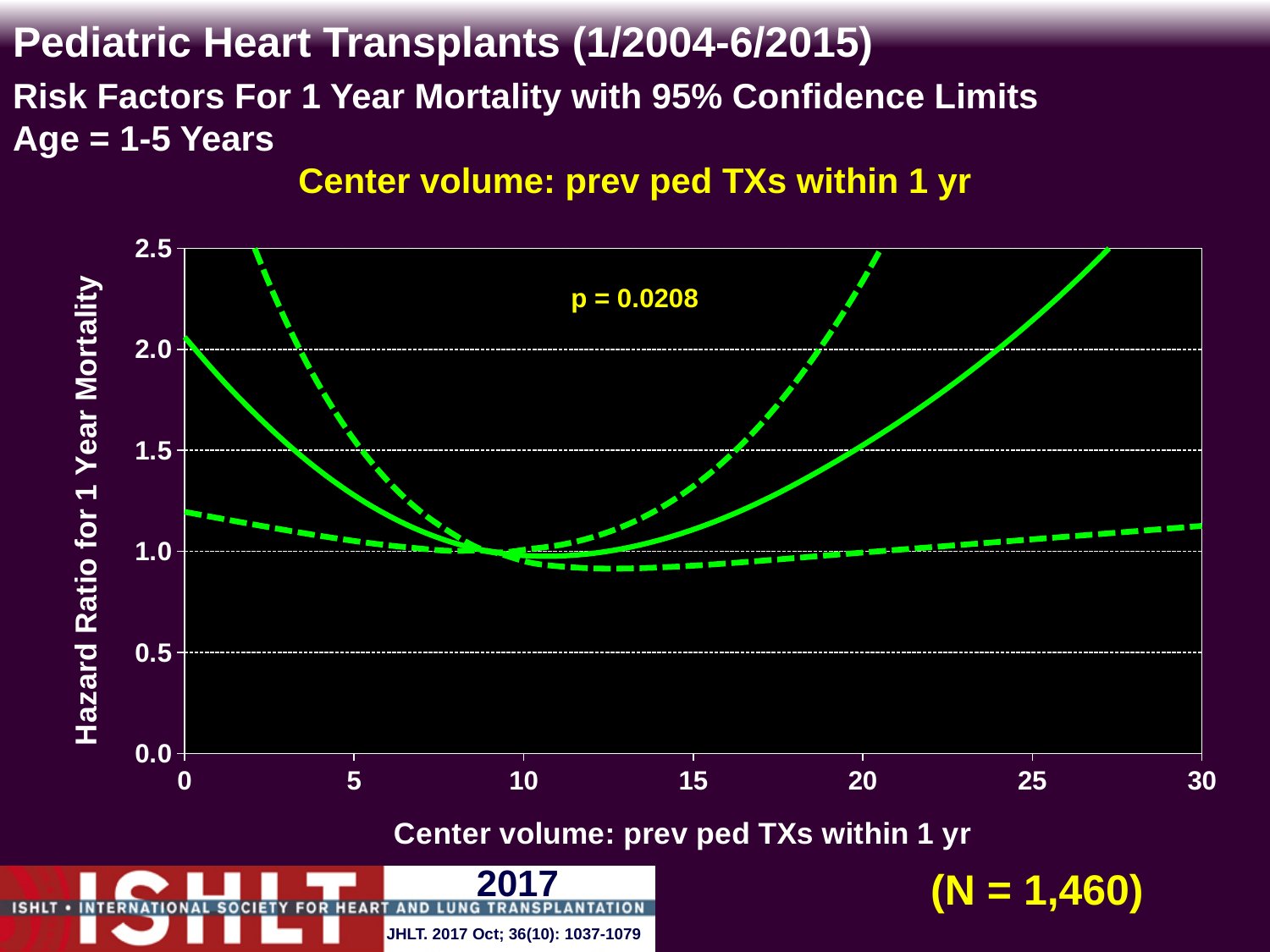
What is the label of the y axis? Hazard Ratio for 1 Year Mortality Does the solid hazard ratio line rise or fall as center volume increases from 0 to 10? fall What is the title of the chart? Center volume: prev ped TXs within 1 yr What sample size (N) is printed on the slide? N = 1,460 Is the hazard ratio on the solid line at a center volume of 15 greater or less than 1.5? less Is the hazard ratio on the solid line at a center volume of 10 greater or less than 1.5? less What p-value is printed on the chart? p = 0.0208 What kind of chart is shown on the slide? line chart Is the hazard ratio on the solid line at a center volume of 0 greater or less than 1.5? greater How many curves are plotted on the chart? 3 Does the solid hazard ratio line rise or fall as center volume increases from 15 to 30? rise What is the highest value shown on the y axis? 2.5